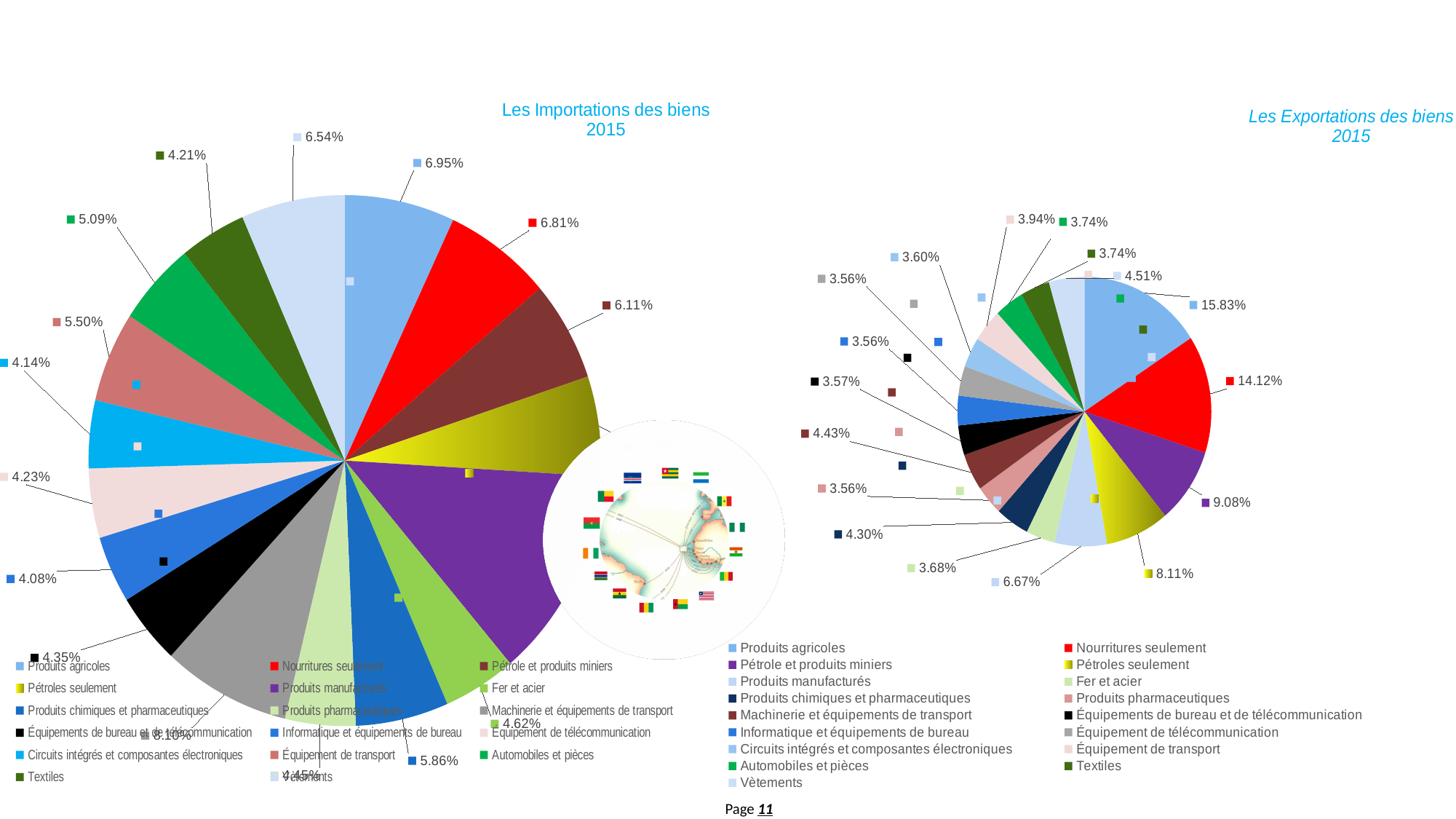
In the 'Les Importations des biens 2015' chart, what is the share for Vêtements? 6.54% In the 'Les Importations des biens 2015' chart, what is the share for Machinerie et équipements de transport? 8.10% In the 'Les Exportations des biens 2015' chart, what is the share for Nourritures seulement? 14.12% What is the title of the pie chart on the left of the slide? Les Importations des biens 2015 In the 'Les Exportations des biens 2015' chart, what is the share for Produits manufacturés? 6.67% In the 'Les Exportations des biens 2015' chart, which category has the largest share? Produits agricoles How many categories does the legend of the 'Les Exportations des biens 2015' chart list? 17 In the 'Les Exportations des biens 2015' chart, which is larger: Pétrole et produits miniers or Pétroles seulement? Pétrole et produits miniers In the 'Les Exportations des biens 2015' chart, what is the difference between the shares of Produits agricoles and Nourritures seulement? 1.71% In the 'Les Importations des biens 2015' chart, what is the share for Produits agricoles? 6.95% What kind of chart is 'Les Importations des biens 2015'? Pie chart In the 'Les Exportations des biens 2015' chart, what is the share for Pétroles seulement? 8.11%